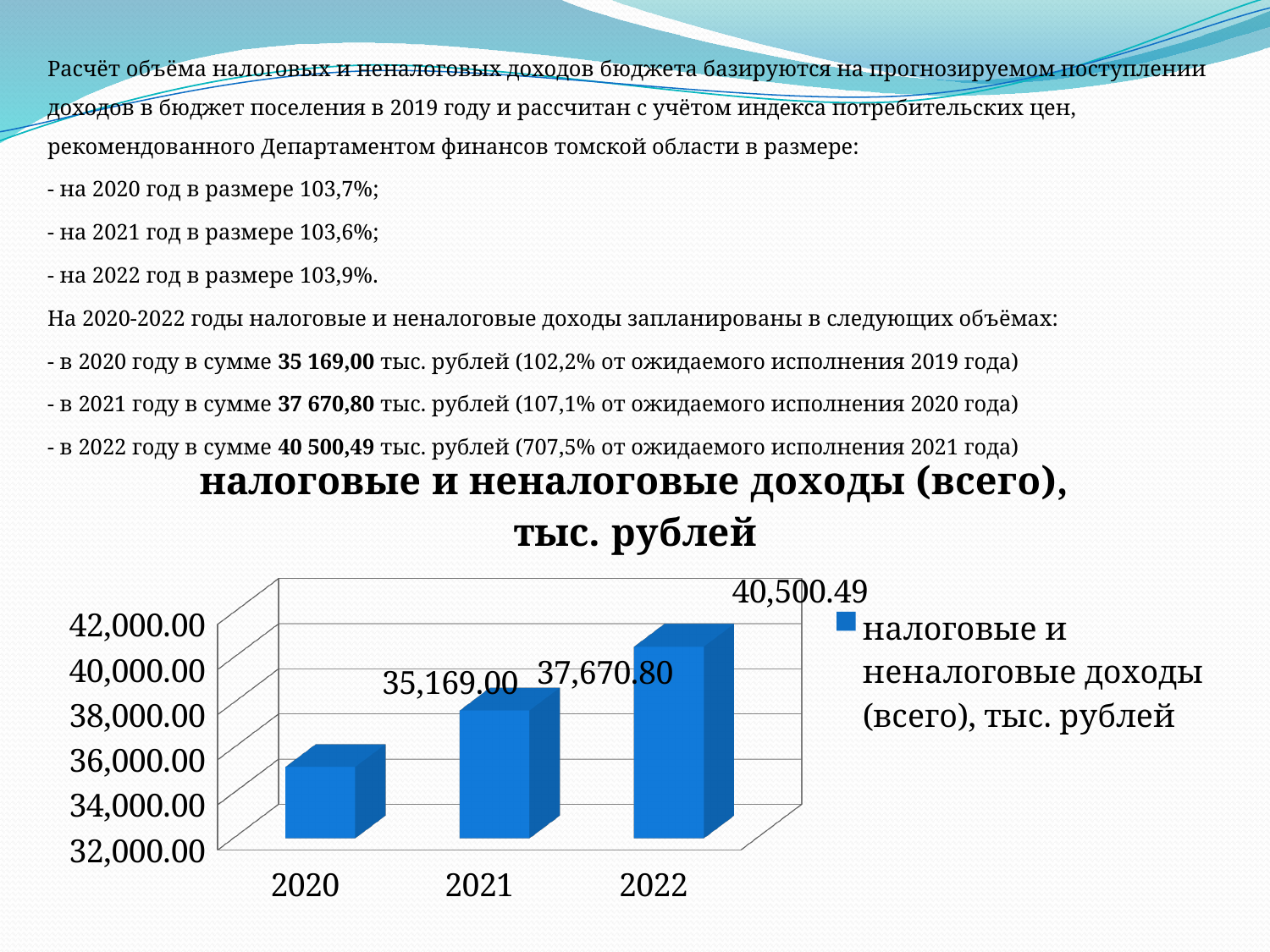
How many years are shown on the x axis of the chart? 3 What kind of chart is shown on the slide? bar chart Which is larger, the value for 2021 or the value for 2022? 2022 What is the value for 2022 in the chart? 40,500.49 What is the value for 2021 in the chart? 37,670.80 Which year has the highest value in the chart? 2022 What is the difference between the values for 2021 and 2020? 2,501.80 Do the values rise or fall from 2020 to 2022? rise What is the difference between the values for 2022 and 2021? 2,829.69 Is the value for 2020 greater or less than 36,000.00? less What is the value for 2020 in the chart? 35,169.00 Which year has the lowest value in the chart? 2020